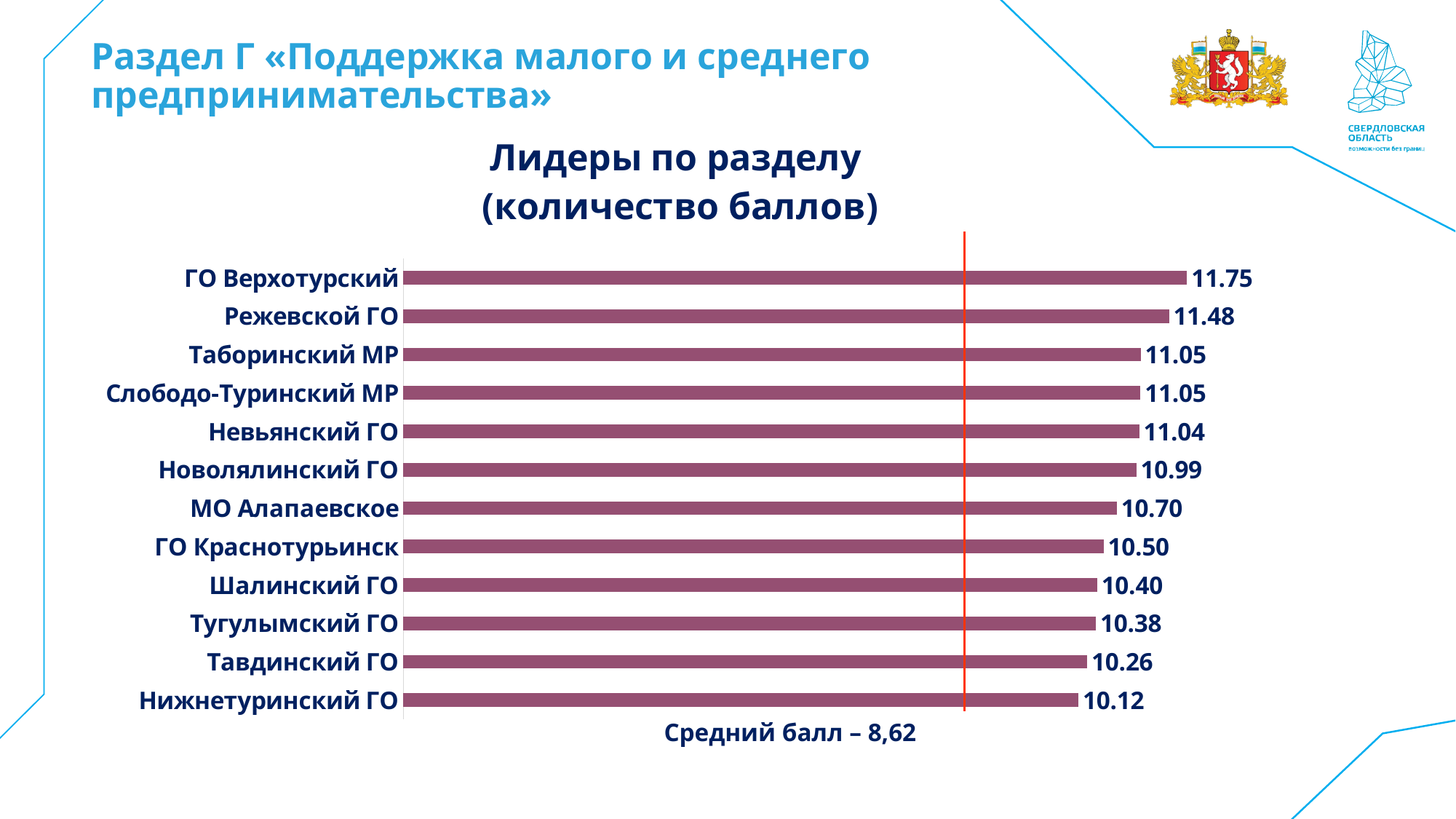
What is the value for МО Алапаевское? 10.70 What is the value for ГО Верхотурский? 11.75 Which category has the highest value? ГО Верхотурский How many categories are shown in the chart? 12 What is the value for Невьянский ГО? 11.04 What kind of chart is shown on the slide? bar chart What is the difference between the values for ГО Верхотурский and Режевской ГО? 0.27 What is the value for Нижнетуринский ГО? 10.12 What is the title of the chart? Лидеры по разделу (количество баллов) What is the difference between the values for ГО Краснотурьинск and Тавдинский ГО? 0.24 Which category has the lowest value? Нижнетуринский ГО Which is larger, the value for Шалинский ГО or the value for Тавдинский ГО? Шалинский ГО